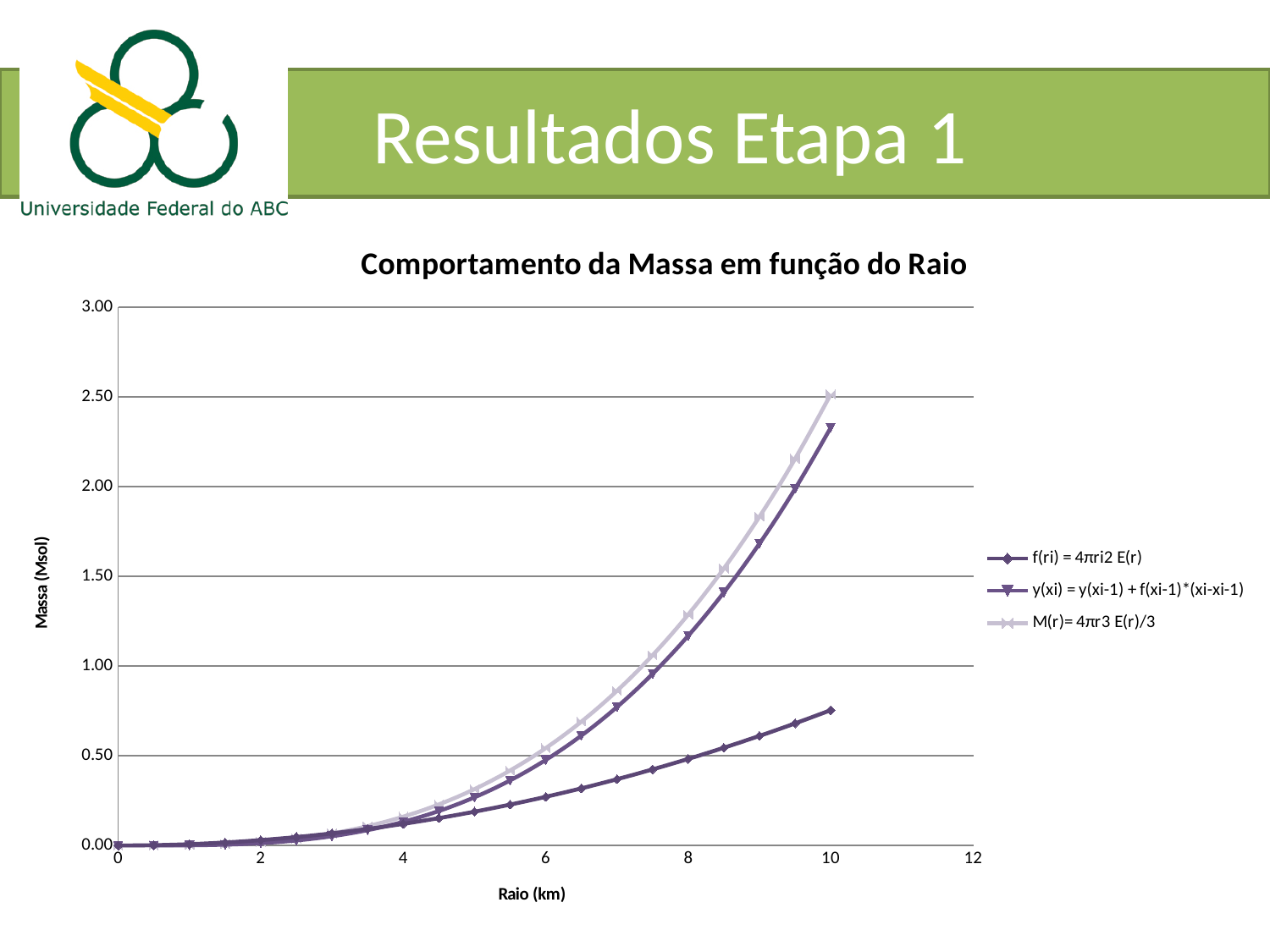
What kind of chart is shown on the slide? line chart Is the value of the y(xi) = y(xi-1) + f(xi-1)*(xi-xi-1) series at Raio 10 km greater or less than 2.00? greater Which series reaches the highest value at Raio 10 km? M(r)= 4πr3 E(r)/3 At Raio 10 km, which series has the larger value: M(r)= 4πr3 E(r)/3 or f(ri) = 4πri2 E(r)? M(r)= 4πr3 E(r)/3 Is the value of the M(r)= 4πr3 E(r)/3 series at Raio 8 km greater or less than 1.00? greater Is the value of the f(ri) = 4πri2 E(r) series at Raio 6 km greater or less than 0.50? less Which series has the lowest value at Raio 10 km? f(ri) = 4πri2 E(r) What is the title of the chart? Comportamento da Massa em função do Raio What is the label of the y axis? Massa (Msol) Do the values of the M(r)= 4πr3 E(r)/3 series rise or fall as Raio (km) increases? rise How many series does the legend list? 3